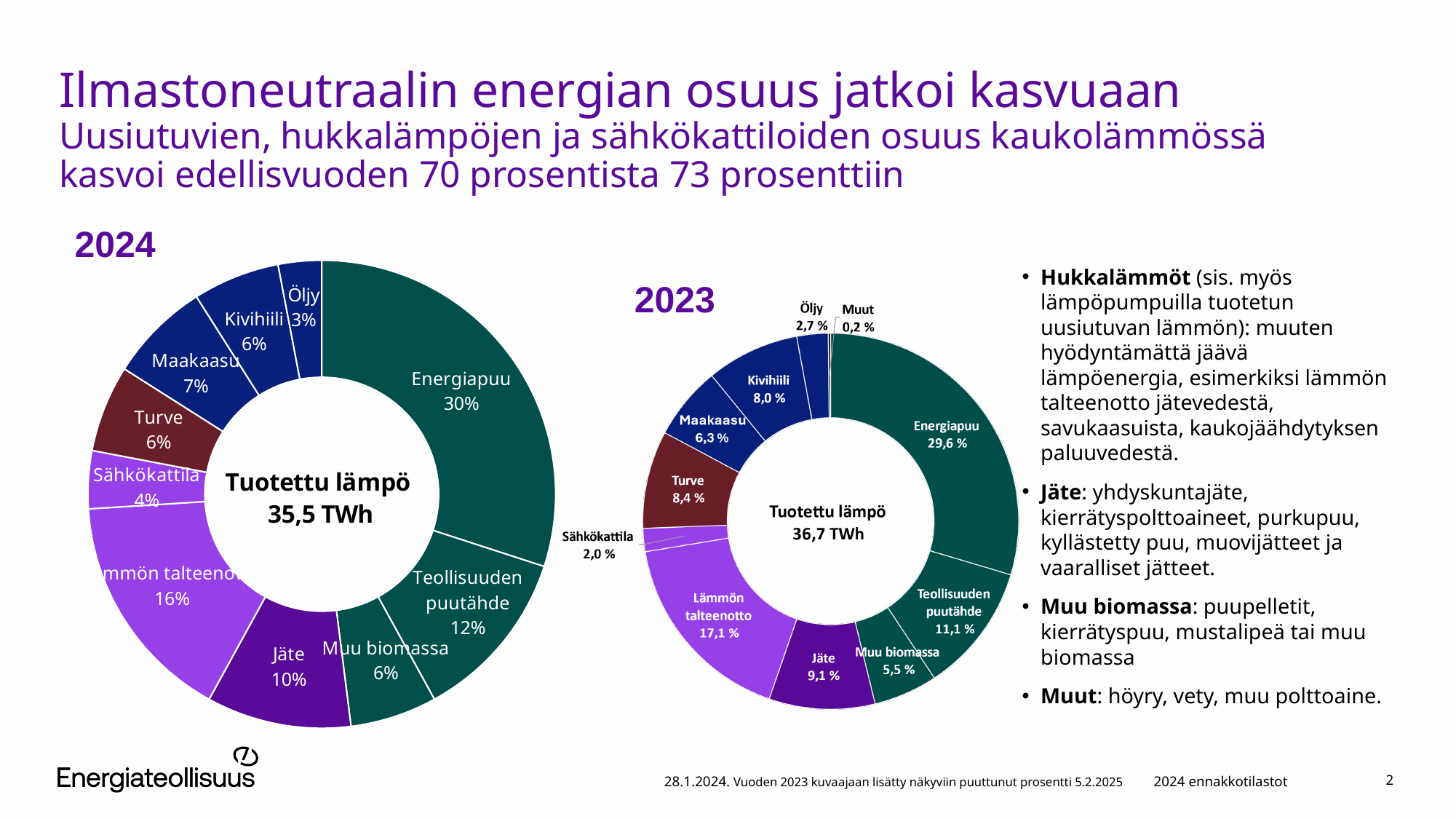
What kind of chart is the 2024 chart? Donut (pie) chart In the 2024 chart, what share does Energiapuu have? 30% In the 2023 chart, which category has the smallest share? Muut In the 2024 chart, which category has the largest share? Energiapuu What total heat production is shown in the centre of the 2023 chart? 36,7 TWh What total heat production is shown in the centre of the 2024 chart? 35,5 TWh In the 2023 chart, which is larger, the share of Kivihiili or the share of Maakaasu? Kivihiili In the 2023 chart, what share does Lämmön talteenotto have? 17,1 % How many categories are shown in the 2023 chart? 11 In the 2024 chart, what is the difference between the shares of Lämmön talteenotto and Jäte? 6 percentage points How many categories are shown in the 2024 chart? 10 In the 2023 chart, what share does Turve have? 8,4 %